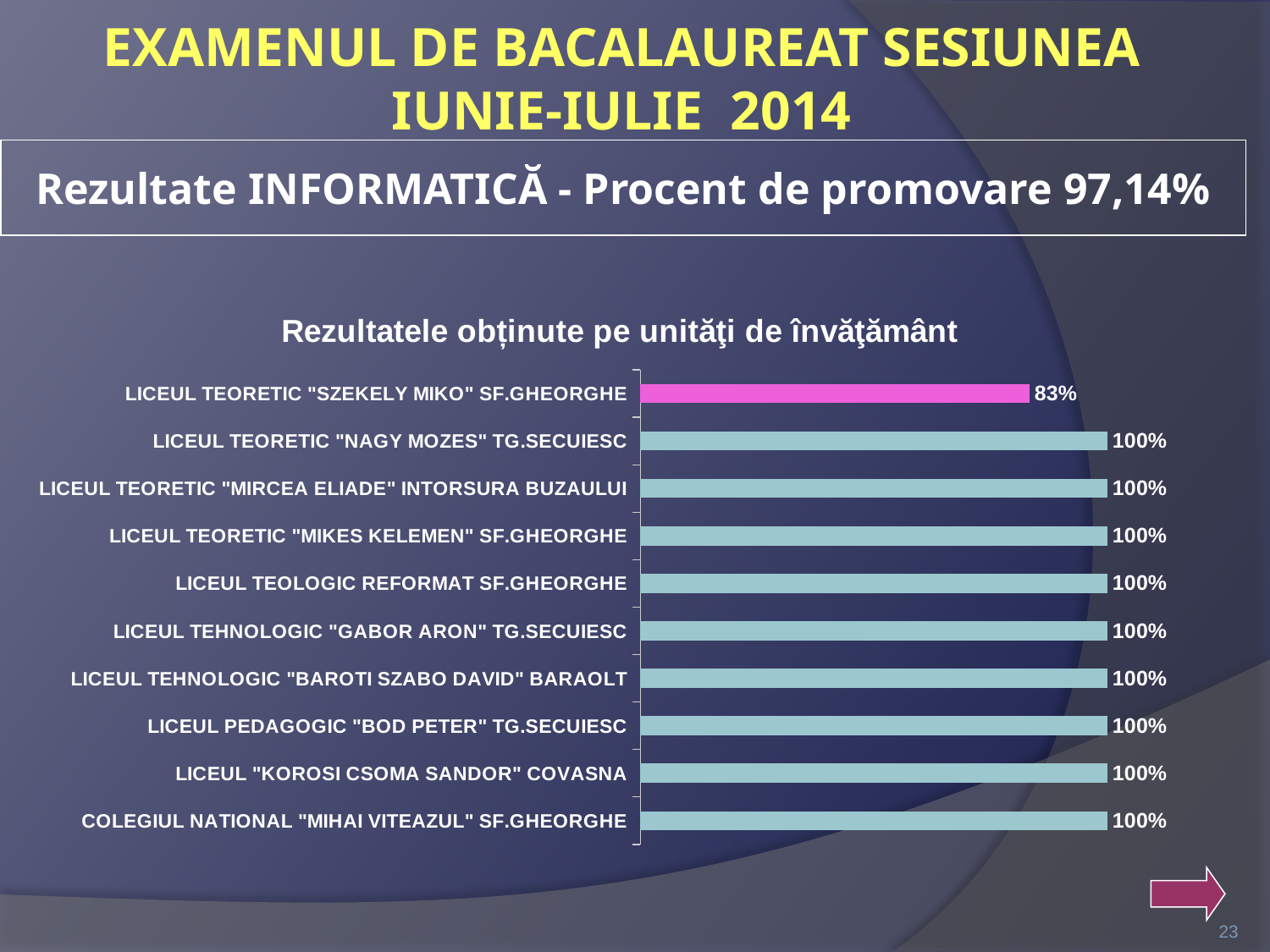
Which bar is coloured differently (pink) from the others? LICEUL TEORETIC "SZEKELY MIKO" SF.GHEORGHE What is the value for LICEUL PEDAGOGIC "BOD PETER" TG.SECUIESC? 100% How many schools have a value of 100%? 9 Which school has the lowest value in the chart? LICEUL TEORETIC "SZEKELY MIKO" SF.GHEORGHE What is the value for LICEUL TEHNOLOGIC "GABOR ARON" TG.SECUIESC? 100% What is the difference between the value for LICEUL TEORETIC "NAGY MOZES" TG.SECUIESC and the value for LICEUL TEORETIC "SZEKELY MIKO" SF.GHEORGHE? 17% What is the title of the chart? Rezultatele obținute pe unităţi de învăţământ How many schools are shown in the chart? 10 What is the value for LICEUL TEORETIC "SZEKELY MIKO" SF.GHEORGHE? 83% What kind of chart is shown on the slide? bar chart What is the value for COLEGIUL NATIONAL "MIHAI VITEAZUL" SF.GHEORGHE? 100% Which is larger: the value for LICEUL "KOROSI CSOMA SANDOR" COVASNA or the value for LICEUL TEORETIC "SZEKELY MIKO" SF.GHEORGHE? LICEUL "KOROSI CSOMA SANDOR" COVASNA